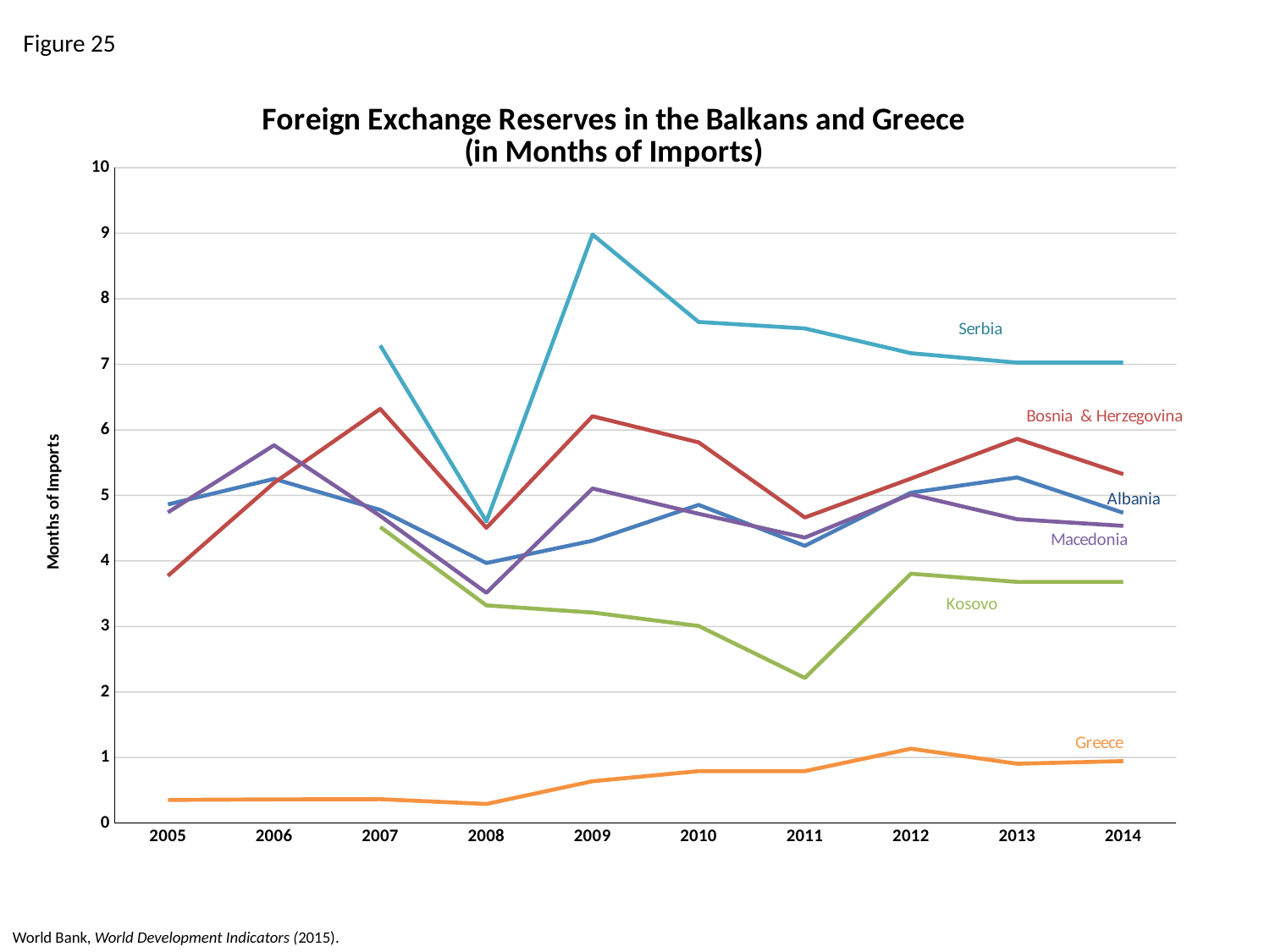
Is the value for Greece in 2008 greater or less than 1? less Is the value for Kosovo in 2011 greater or less than 3? less Which is larger in 2013, the value for Bosnia & Herzegovina or the value for Albania? Bosnia & Herzegovina What is the label on the y axis? Months of Imports In which year is Kosovo's value lowest? 2011 Is the value for Serbia in 2009 greater or less than 8? greater Does Serbia's line rise or fall from 2009 to 2014? fall Which country has the highest foreign exchange reserves in 2009? Serbia Which country has the lowest foreign exchange reserves in every year shown? Greece How many years are plotted along the x axis? 10 What kind of chart is shown on the slide? line chart How many countries are plotted as lines on the chart? 6